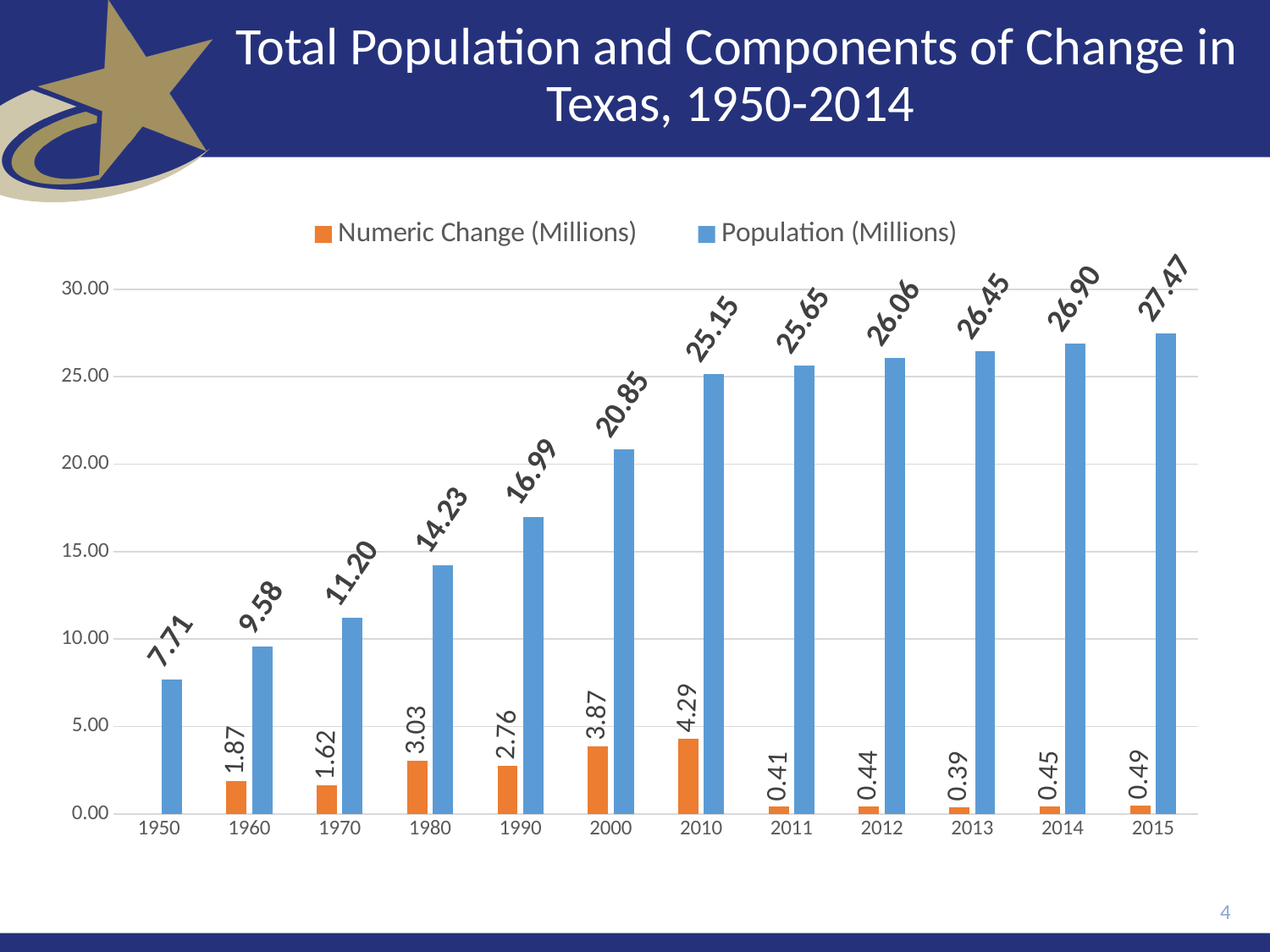
How many series does the legend list? 2 Which year has the lowest Numeric Change (Millions) value among those labelled? 2013 What is the Numeric Change (Millions) value for 2010? 4.29 Is the Population (Millions) value for 1990 greater or less than 15.00? greater How many years are shown on the x axis? 12 Which year has the highest Population (Millions) value? 2015 Does the Population (Millions) series rise or fall from 1950 to 2015? Rise What is the Population (Millions) value for 2000? 20.85 What is the Numeric Change (Millions) value for 2013? 0.39 What kind of chart is shown on the slide? Bar chart Which is larger, the Numeric Change (Millions) for 1980 or for 1990? 1980 What is the difference between the Population (Millions) values for 2015 and 1950? 19.76